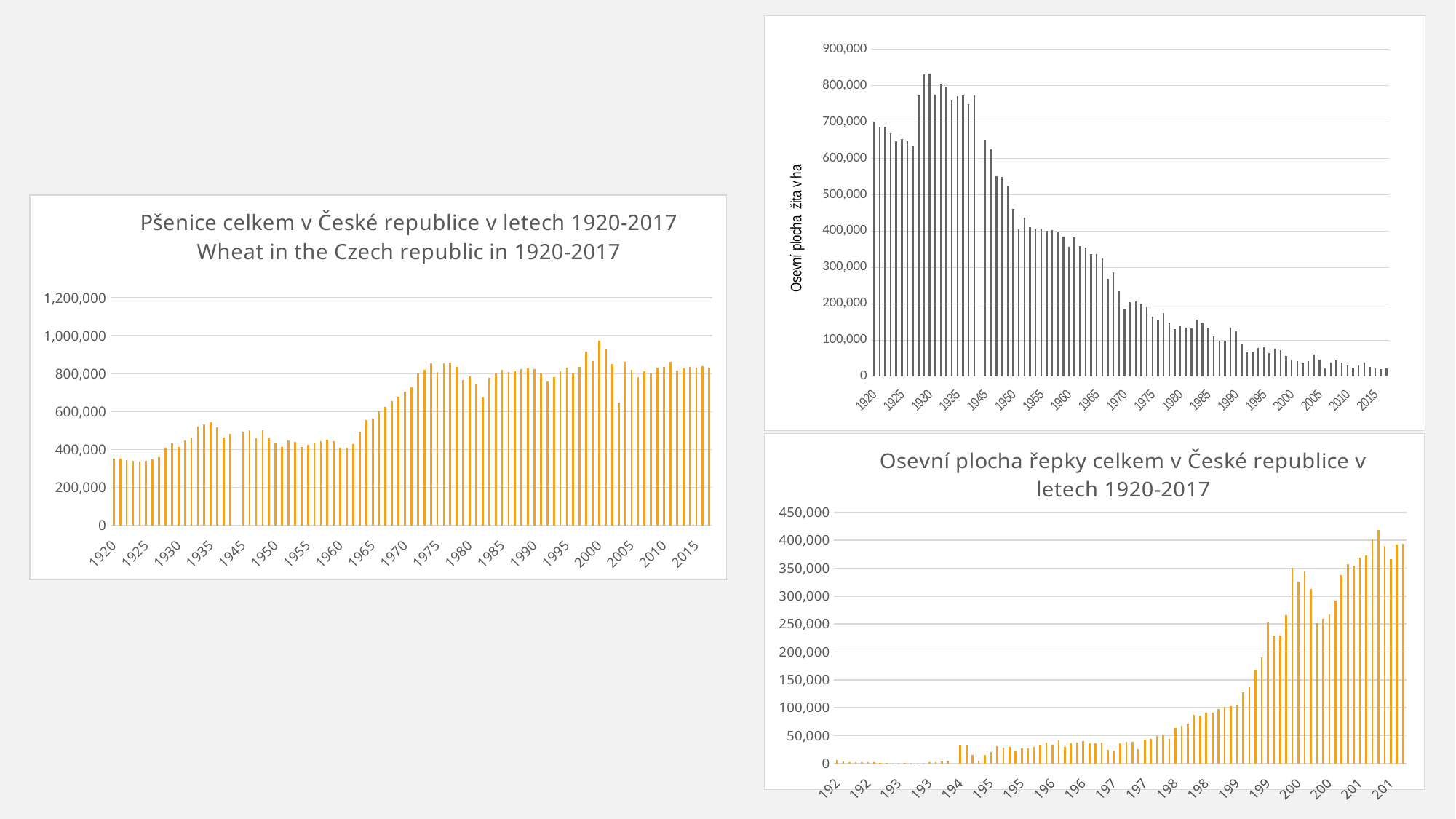
In the 'Osevní plocha řepky celkem v České republice v letech 1920-2017' chart, is the value for 1920 greater or less than 50,000? less In the 'Wheat in the Czech republic in 1920-2017' chart, is the value for 1920 greater or less than 400,000? less In the 'Wheat in the Czech republic in 1920-2017' chart, is the value for 2000 greater or less than 800,000? greater In the 'Wheat in the Czech republic in 1920-2017' chart, do the values overall rise or fall from 1920 to 2017? rise In the 'Osevní plocha řepky celkem v České republice v letech 1920-2017' chart, do the values overall rise or fall from 1920 to 2017? rise What kind of chart is the 'Wheat in the Czech republic in 1920-2017' chart on the left? bar chart What is the y-axis label of the top-right chart? Osevní plocha žita v ha In the 'Wheat in the Czech republic in 1920-2017' chart, which is larger, the value for 1920 or the value for 2000? 2000 In the top-right chart (rye, 'Osevní plocha žita v ha'), do the values overall rise or fall from 1920 to 2017? fall